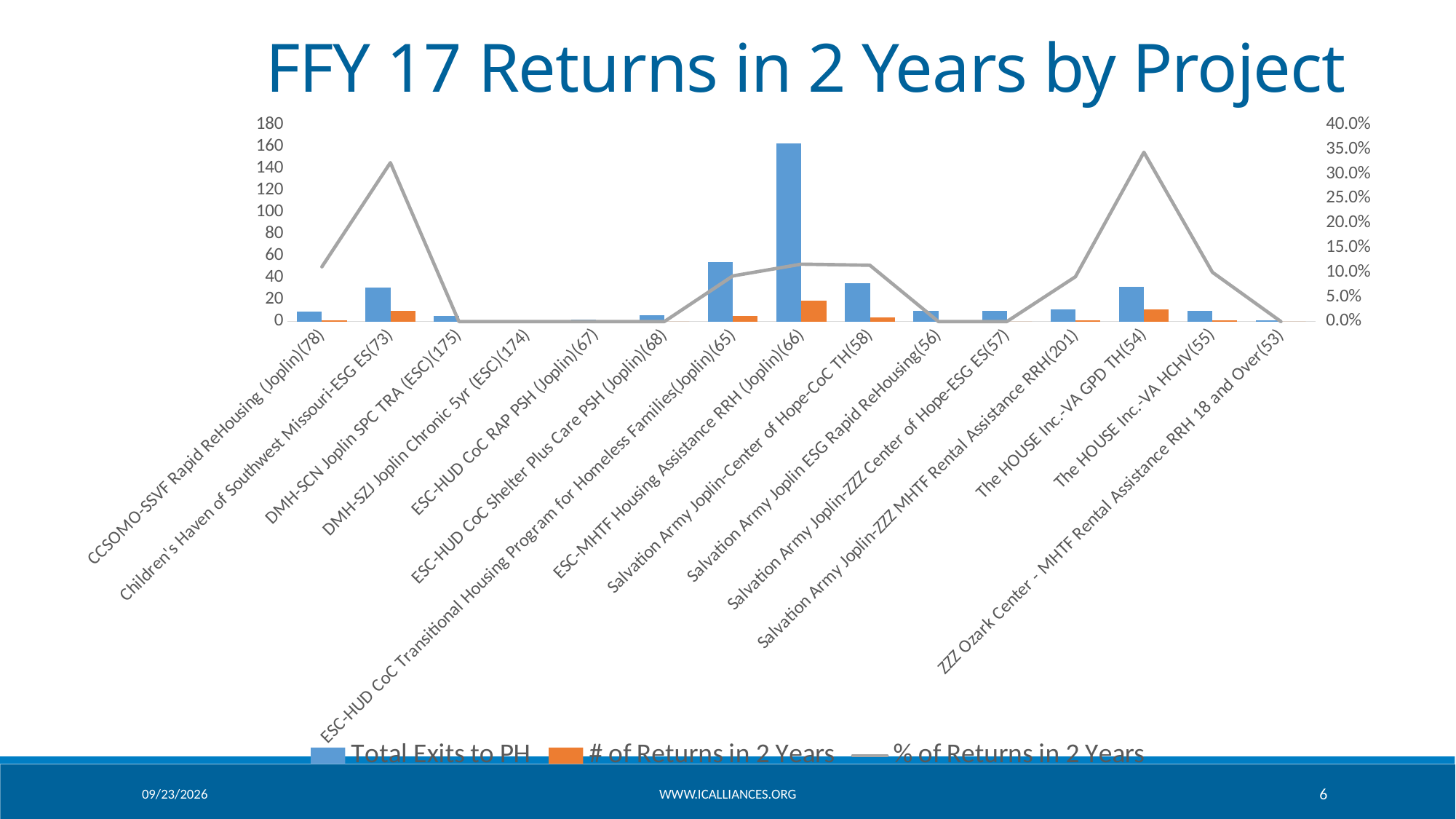
Which has more Total Exits to PH: ESC-MHTF Housing Assistance RRH (Joplin)(66) or Salvation Army Joplin-Center of Hope-CoC TH(58)? ESC-MHTF Housing Assistance RRH (Joplin)(66) Which project has the highest % of Returns in 2 Years? The HOUSE Inc.-VA GPD TH(54) Is the Total Exits to PH value for ESC-HUD CoC Transitional Housing Program for Homeless Families(Joplin)(65) greater or less than 40? greater How many series does the legend list? 3 Is the % of Returns in 2 Years for The HOUSE Inc.-VA GPD TH(54) greater or less than 30.0%? greater How many projects (categories) are shown on the x axis? 15 What is the title of the chart? FFY 17 Returns in 2 Years by Project Which project has the highest Total Exits to PH? ESC-MHTF Housing Assistance RRH (Joplin)(66) Is the Total Exits to PH value for ESC-MHTF Housing Assistance RRH (Joplin)(66) greater or less than 140? greater Which project has the highest # of Returns in 2 Years? ESC-MHTF Housing Assistance RRH (Joplin)(66) What kind of chart is shown on the slide? A combination bar and line chart